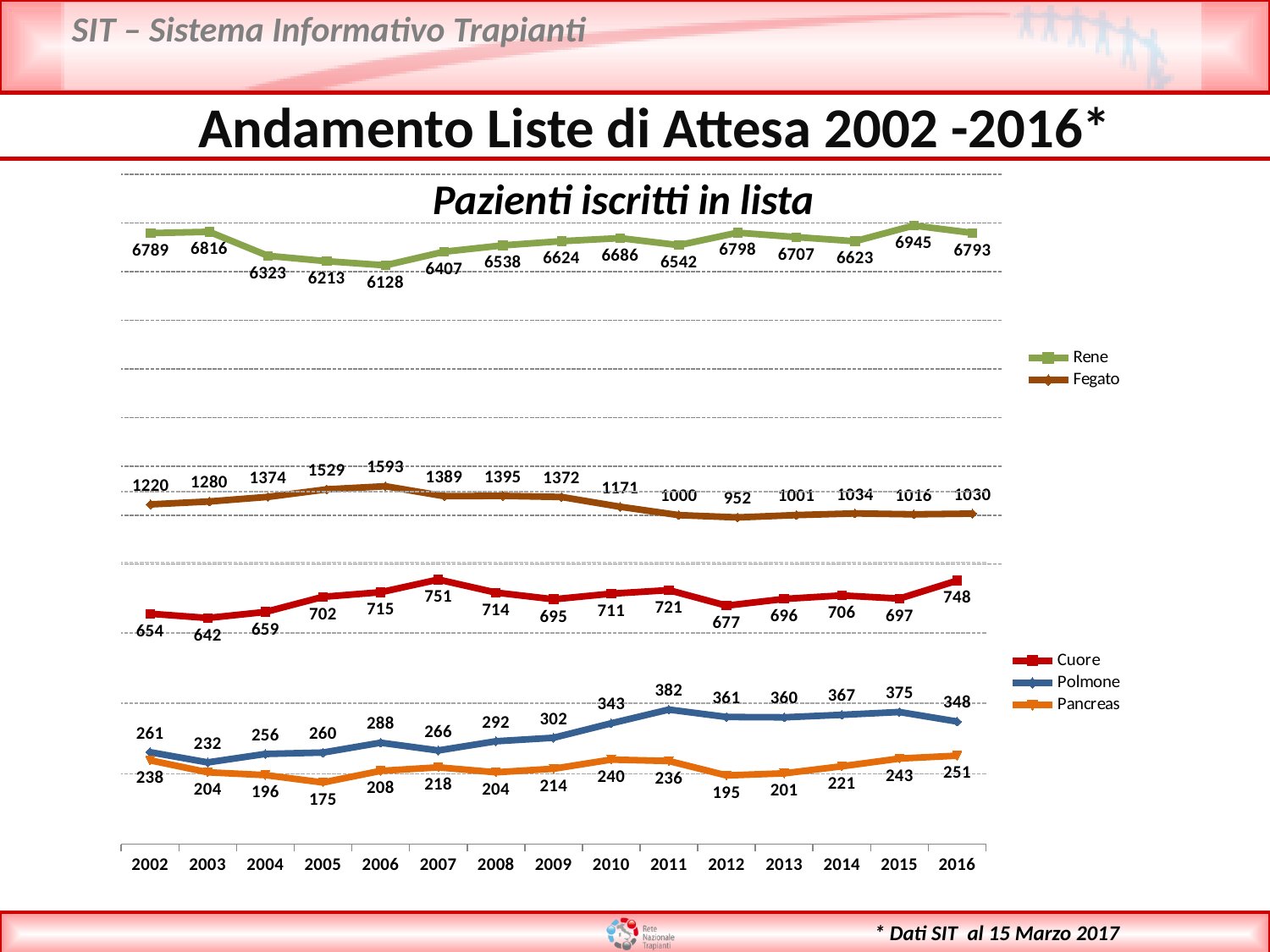
How many years are shown on the x axis? 15 What is the difference between the Fegato value in 2006 and in 2012? 641 What is the value for Pancreas in 2016? 251 Which is larger, the Polmone value in 2002 or the Pancreas value in 2002? Polmone In which year is the Polmone series highest? 2011 In which year is the Fegato series lowest? 2012 What is the difference between the Cuore value in 2016 and in 2002? 94 What is the value for Fegato in 2011? 1000 What is the value for Rene in 2006? 6128 How many series are listed in the legends? 5 What kind of chart is shown on the slide? Line chart In which year is the Rene series highest? 2015